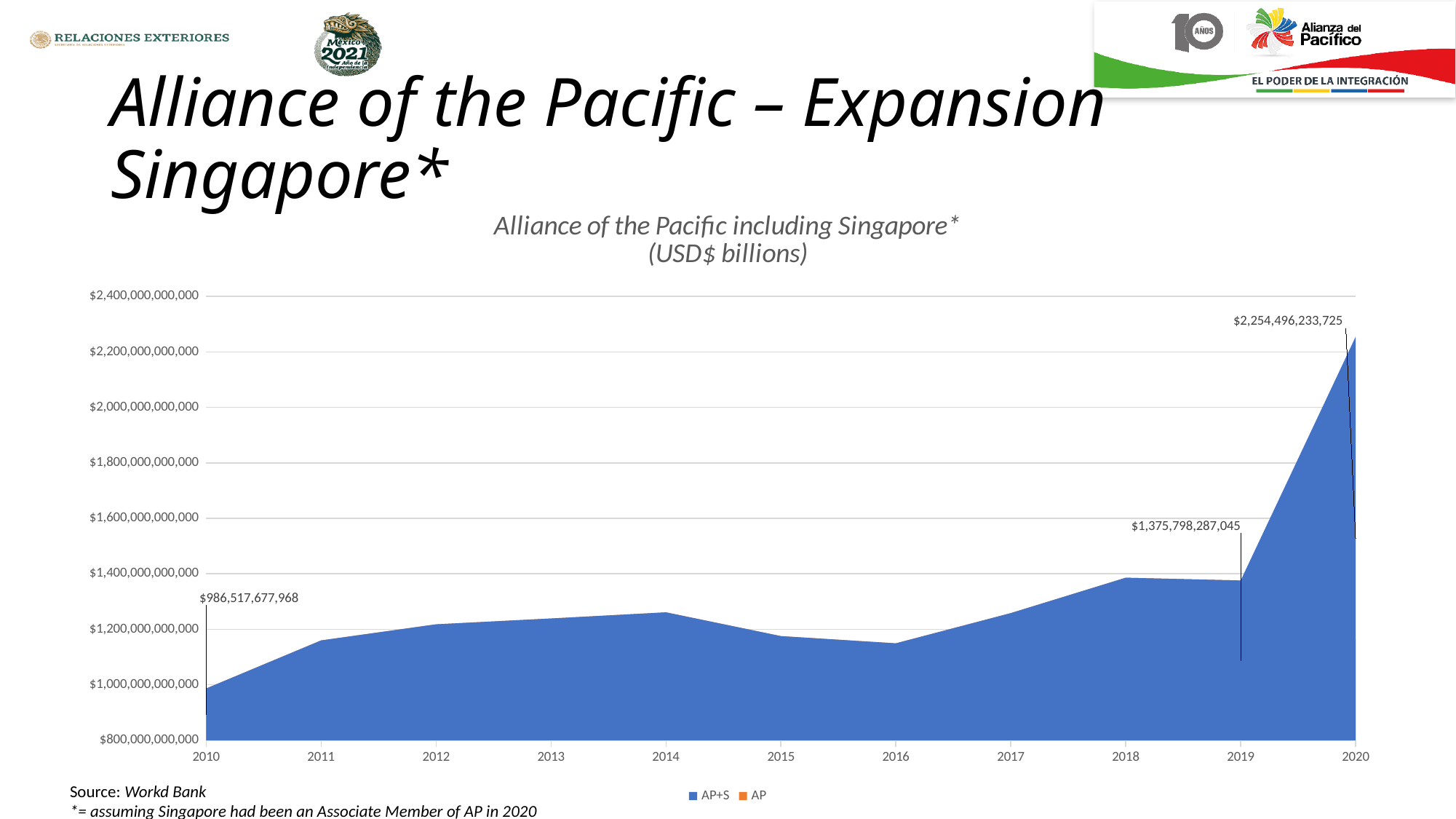
How many series does the legend list? 2 What is the difference between the 2019 value and the 2010 value? $389,280,609,077 What kind of chart is this? Area chart What is the value shown for 2019? $1,375,798,287,045 How many years are shown on the x axis? 11 Which year has the lowest value? 2010 Is the value for 2016 greater or less than $1,200,000,000,000? less Is the value for 2014 greater or less than $1,200,000,000,000? greater What is the difference between the 2020 value and the 2019 value? $878,697,946,680 What is the value shown for 2010? $986,517,677,968 What is the value shown for 2020? $2,254,496,233,725 Which year has the highest value? 2020